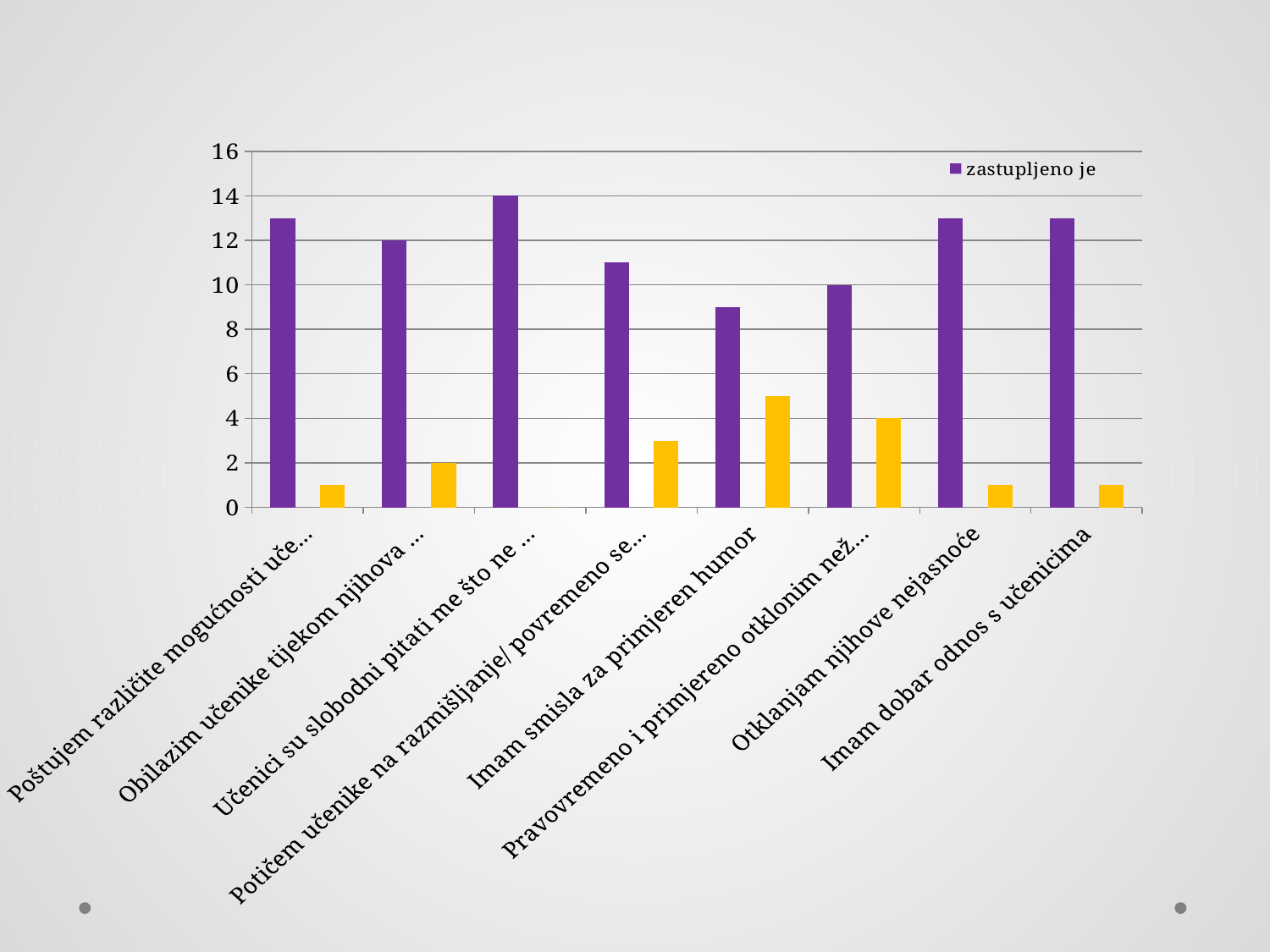
What is the value of the yellow bar for 'Pravovremeno i primjereno otklonim než...'? 4 Is the purple 'zastupljeno je' value for 'Imam smisla za primjeren humor' greater or less than 10? less How many categories are shown along the x axis? 8 What is the difference between the purple 'zastupljeno je' values for 'Učenici su slobodni pitati me što ne ...' and 'Obilazim učenike tijekom njihova ...'? 2 What is the value of the purple 'zastupljeno je' bar for 'Učenici su slobodni pitati me što ne ...'? 14 How many series does the legend list? 1 Which category has the lowest purple 'zastupljeno je' bar? Imam smisla za primjeren humor What is the value of the purple 'zastupljeno je' bar for 'Pravovremeno i primjereno otklonim než...'? 10 What is the value of the purple 'zastupljeno je' bar for 'Obilazim učenike tijekom njihova ...'? 12 Which category has the highest purple 'zastupljeno je' bar? Učenici su slobodni pitati me što ne ... What kind of chart is shown on the slide? bar chart What is the series name shown in the legend? zastupljeno je